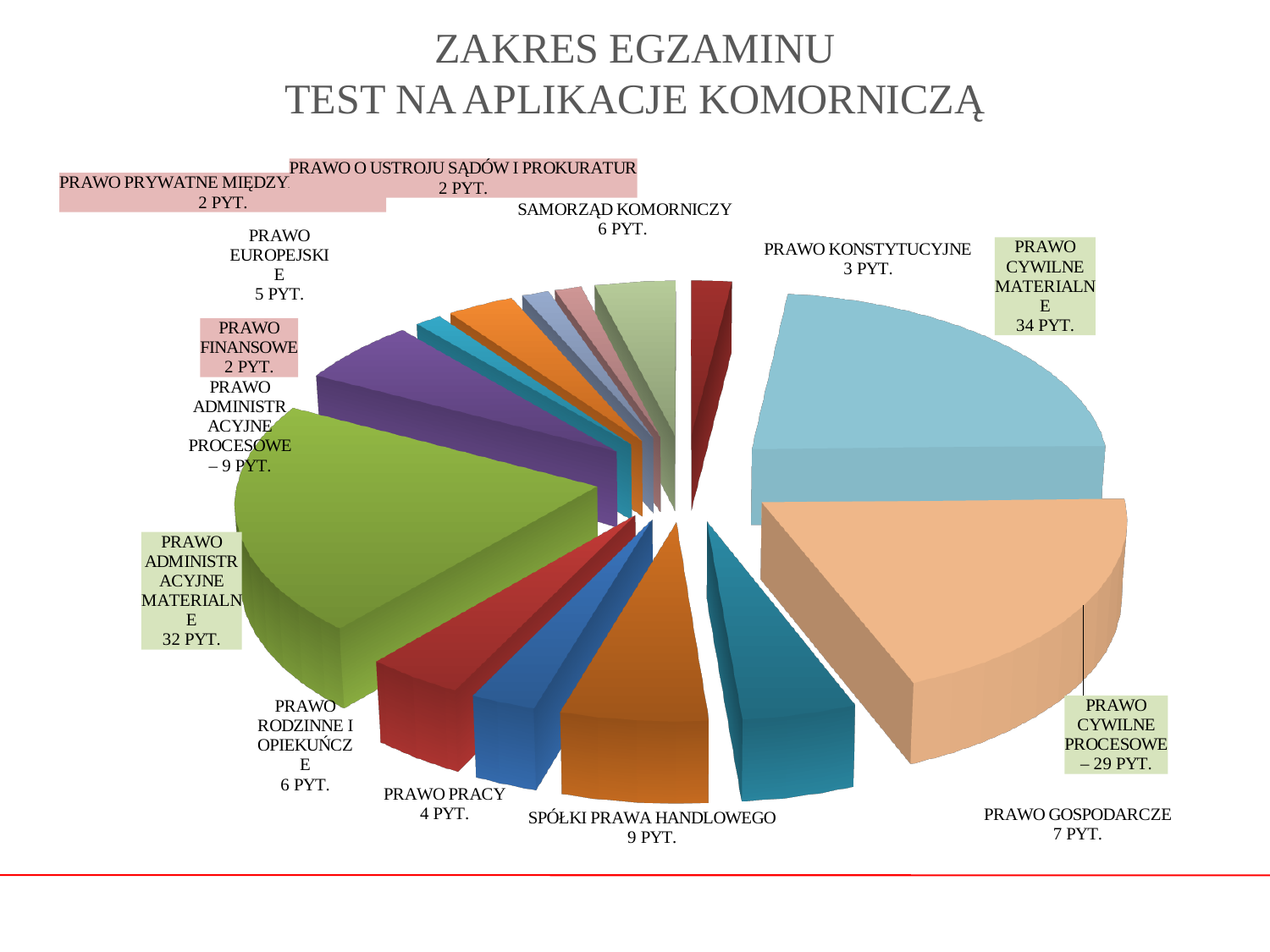
How many questions are shown for SPÓŁKI PRAWA HANDLOWEGO? 9 PYT. How many questions are shown for PRAWO ADMINISTRACYJNE MATERIALNE? 32 PYT. Which has more questions, PRAWO PRACY or PRAWO EUROPEJSKIE? PRAWO EUROPEJSKIE How many questions are shown for SAMORZĄD KOMORNICZY? 6 PYT. What is the title of the slide's chart? ZAKRES EGZAMINU TEST NA APLIKACJE KOMORNICZĄ Which category has the largest number of questions? PRAWO CYWILNE MATERIALNE Which has more questions, PRAWO GOSPODARCZE or SPÓŁKI PRAWA HANDLOWEGO? SPÓŁKI PRAWA HANDLOWEGO What is the difference in questions between PRAWO ADMINISTRACYJNE MATERIALNE and PRAWO CYWILNE PROCESOWE? 3 What kind of chart is shown on the slide? pie chart What is the difference in questions between PRAWO CYWILNE MATERIALNE and PRAWO CYWILNE PROCESOWE? 5 How many slices does the pie chart have? 14 How many questions (PYT.) are shown for PRAWO CYWILNE MATERIALNE? 34 PYT.